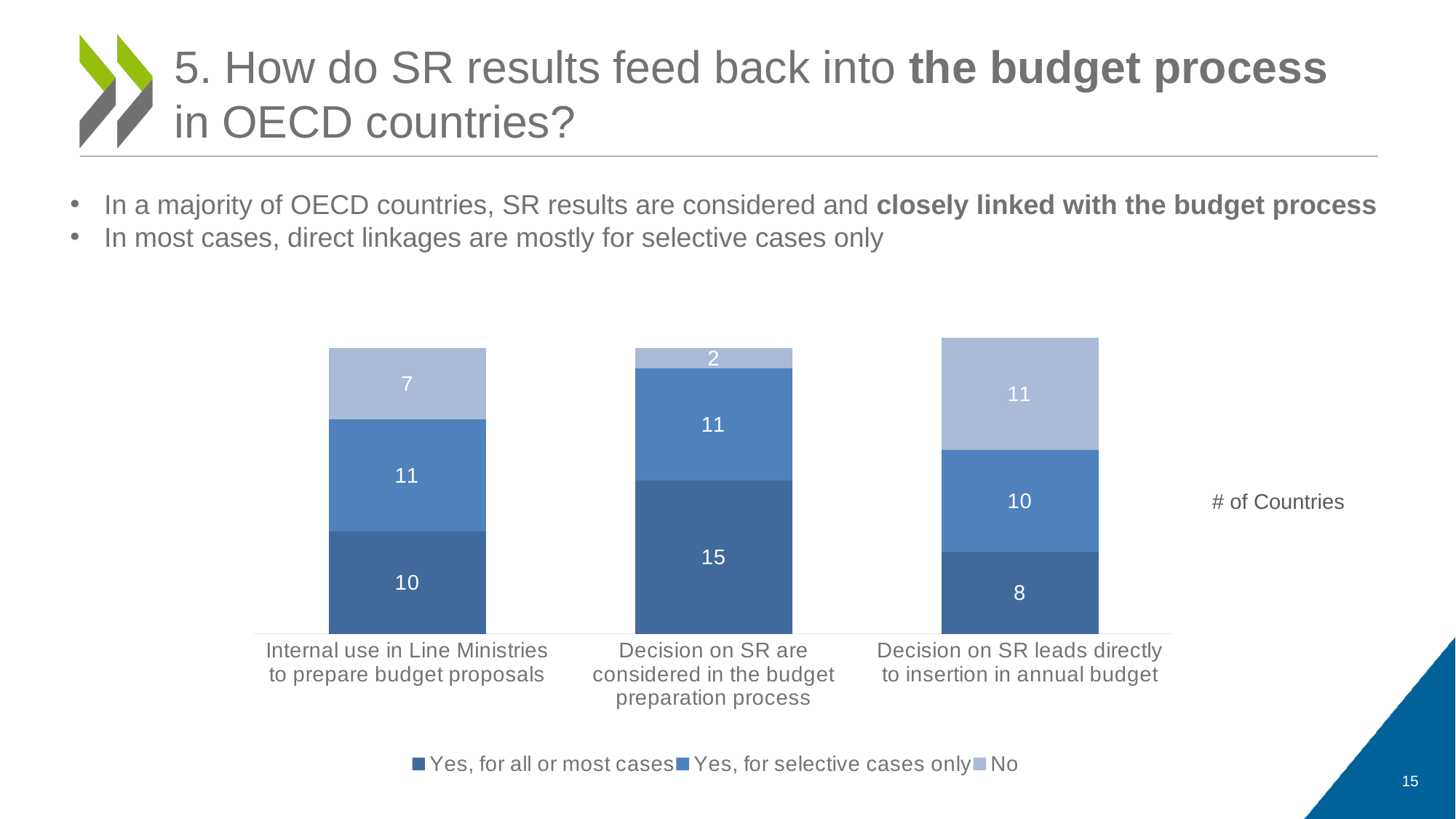
Which category has the lowest value for "No"? Decision on SR are considered in the budget preparation process What is the value for "Yes, for selective cases only" in the "Internal use in Line Ministries to prepare budget proposals" category? 11 What is the value for "No" in the "Decision on SR leads directly to insertion in annual budget" category? 11 How many series does the legend list? 3 What is the total of the stacked bar for "Internal use in Line Ministries to prepare budget proposals"? 28 What kind of chart is shown on the slide? Stacked bar chart How many categories are shown on the x axis? 3 What label appears to the right of the chart describing the unit of the values? # of Countries Which category has the highest value for "Yes, for all or most cases"? Decision on SR are considered in the budget preparation process Which is larger: the "Yes, for all or most cases" value for "Internal use in Line Ministries to prepare budget proposals" or for "Decision on SR leads directly to insertion in annual budget"? Internal use in Line Ministries to prepare budget proposals What is the value for "Yes, for all or most cases" in the "Decision on SR are considered in the budget preparation process" category? 15 What is the difference between the "No" values for "Decision on SR leads directly to insertion in annual budget" and "Decision on SR are considered in the budget preparation process"? 9